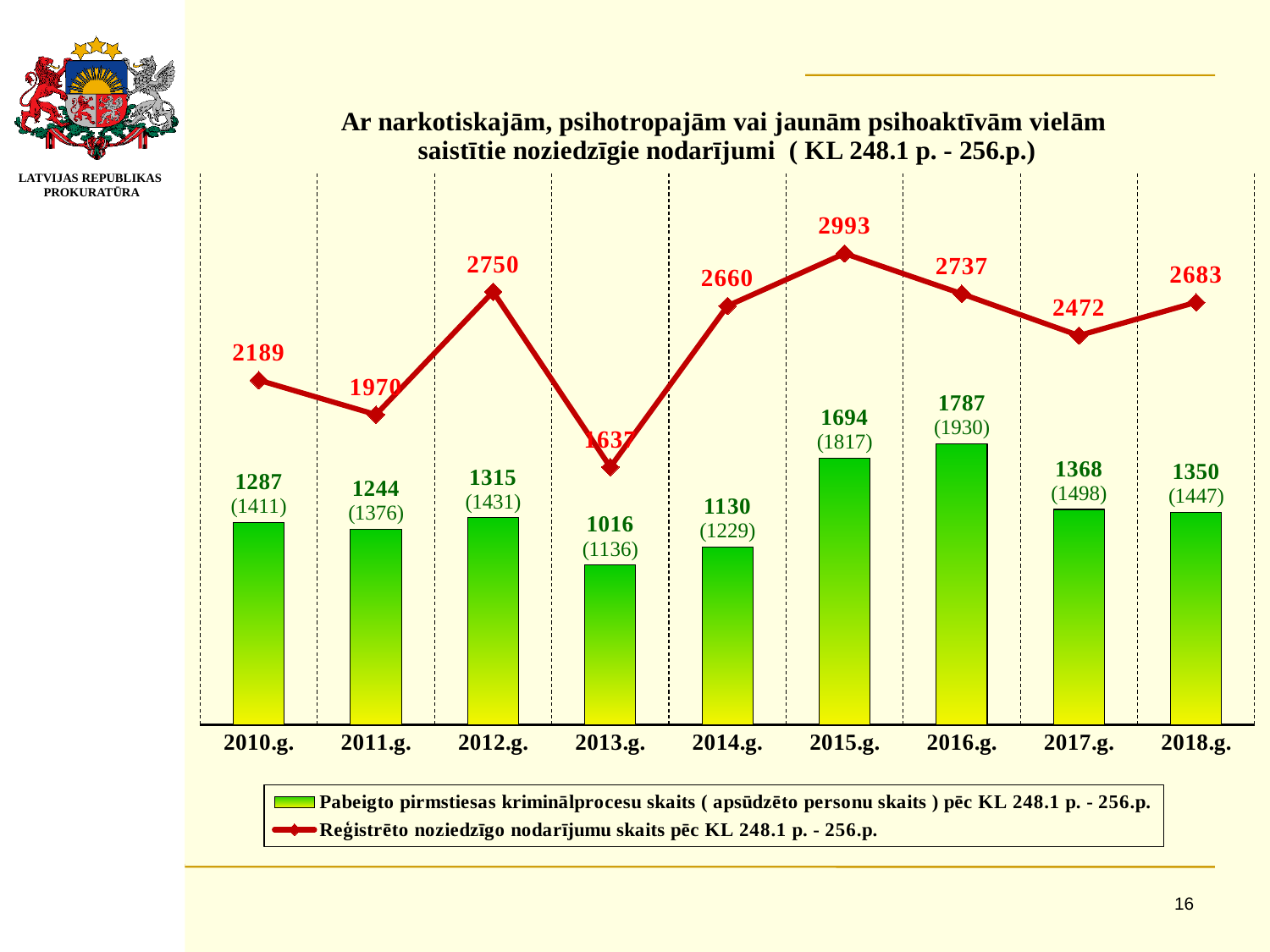
What is the number of completed pre-trial criminal proceedings (green bar) for 2016.g.? 1787 What is the difference between the completed pre-trial criminal proceedings in 2016.g. and 2015.g.? 93 How many years are shown on the x axis of the chart? 9 Which year has the lowest green bar for completed pre-trial criminal proceedings? 2013.g. What is the number in parentheses (accused persons) shown for the 2013.g. bar? 1136 What is the difference between the registered criminal offences in 2015.g. and 2014.g.? 333 What is the registered criminal offences value for 2012.g.? 2750 How many series does the legend list? 2 Which year has the highest value on the red line of registered criminal offences? 2015.g. Which year has a higher registered criminal offences value, 2016.g. or 2018.g.? 2016.g. Did the registered criminal offences value rise or fall from 2017.g. to 2018.g.? rise What is the number of registered criminal offences (red line) for 2015.g.? 2993